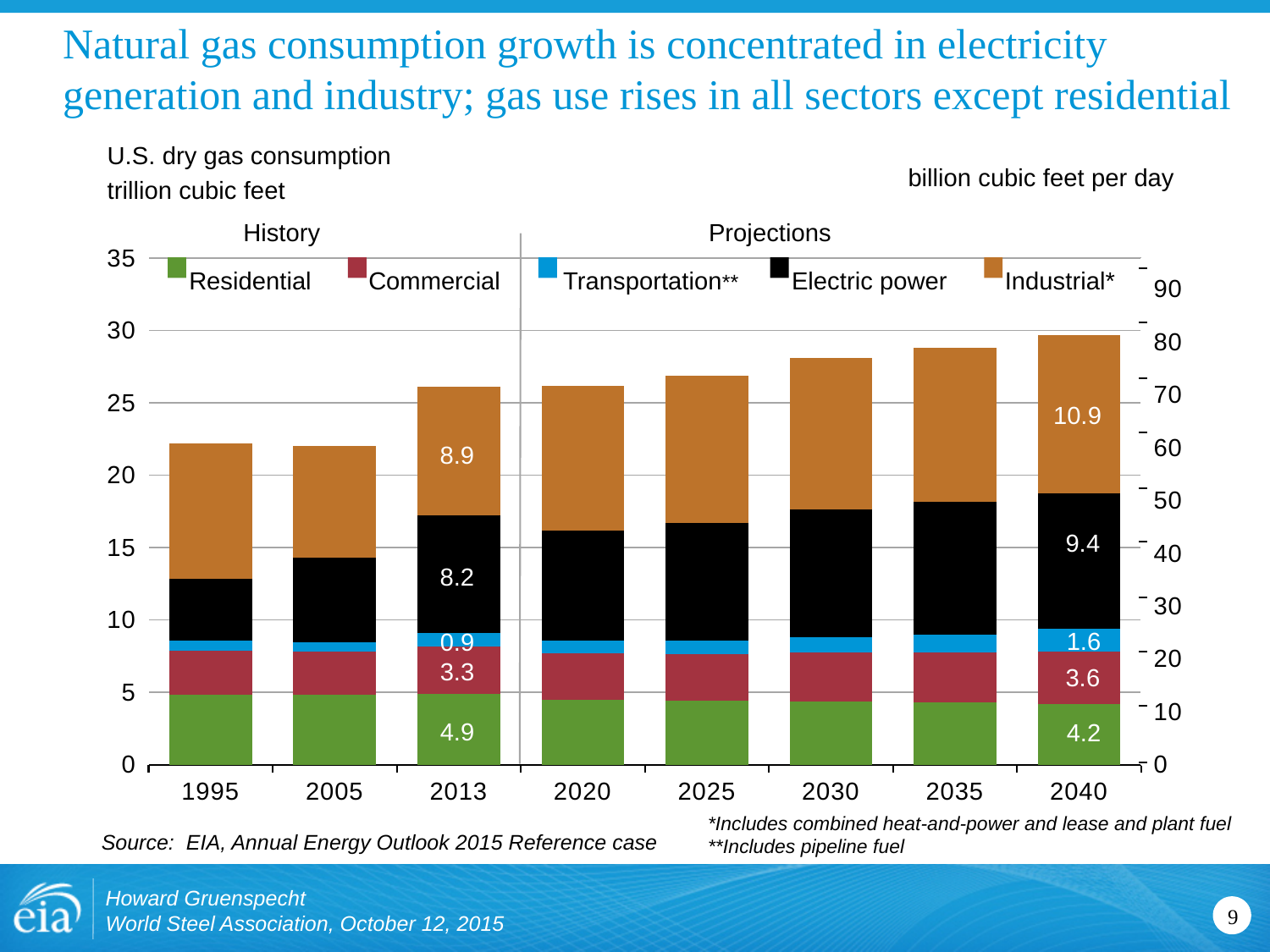
What is the Transportation** value for 2040? 1.6 How many years are shown on the x axis? 8 What is the Industrial* value for 2040? 10.9 Which year has the larger Residential value, 2013 or 2040? 2013 What kind of chart is shown on the slide? Stacked bar chart Is the total consumption for 1995 greater or less than 20 trillion cubic feet? greater What is the total of the stacked bar for 2013? 26.1 How many series does the legend list? 5 By how much does the Industrial* value increase from 2013 to 2040? 2.0 What is the Electric power value for 2013? 8.2 What is the total of the stacked bar for 2040? 29.7 Do the total stacked bar heights rise or fall from 2020 to 2040? rise